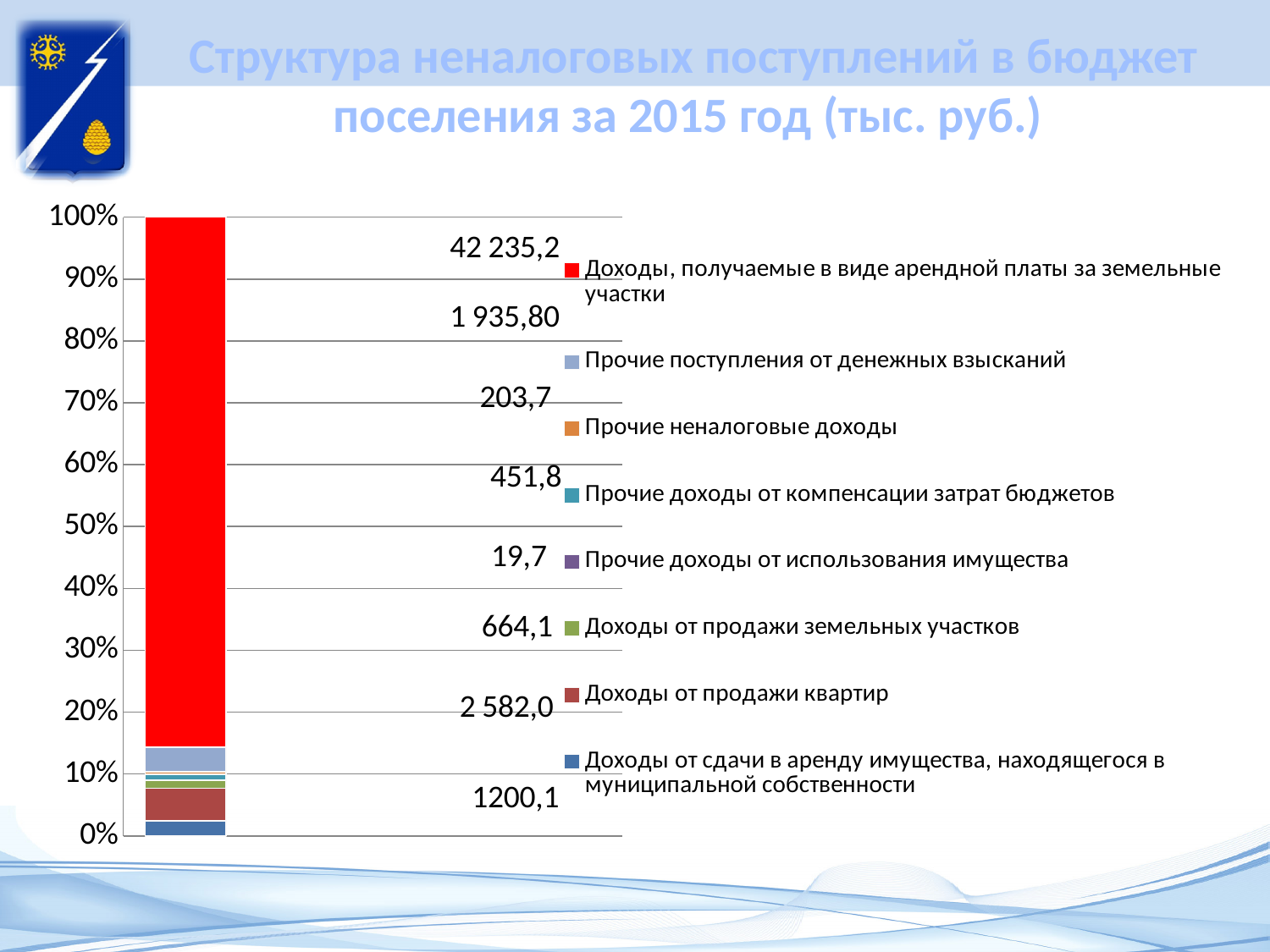
What value is shown for «Доходы от продажи квартир»? 2 582,0 Which category has the lowest value? Прочие доходы от использования имущества Which is larger: «Доходы от продажи земельных участков» or «Прочие доходы от компенсации затрат бюджетов»? Доходы от продажи земельных участков What value is shown for «Прочие доходы от использования имущества»? 19,7 Is the share of the red segment (арендная плата за земельные участки) in the bar greater or less than 80%? greater What is the difference between «Доходы от продажи квартир» and «Доходы от сдачи в аренду имущества, находящегося в муниципальной собственности»? 1381,9 What value is shown for «Прочие поступления от денежных взысканий»? 1 935,80 Which category has the highest value? Доходы, получаемые в виде арендной платы за земельные участки What kind of chart is shown on the slide? Stacked bar chart How many series does the legend list? 8 What value is shown for «Доходы от сдачи в аренду имущества, находящегося в муниципальной собственности»? 1200,1 What value is shown for «Доходы, получаемые в виде арендной платы за земельные участки»? 42 235,2